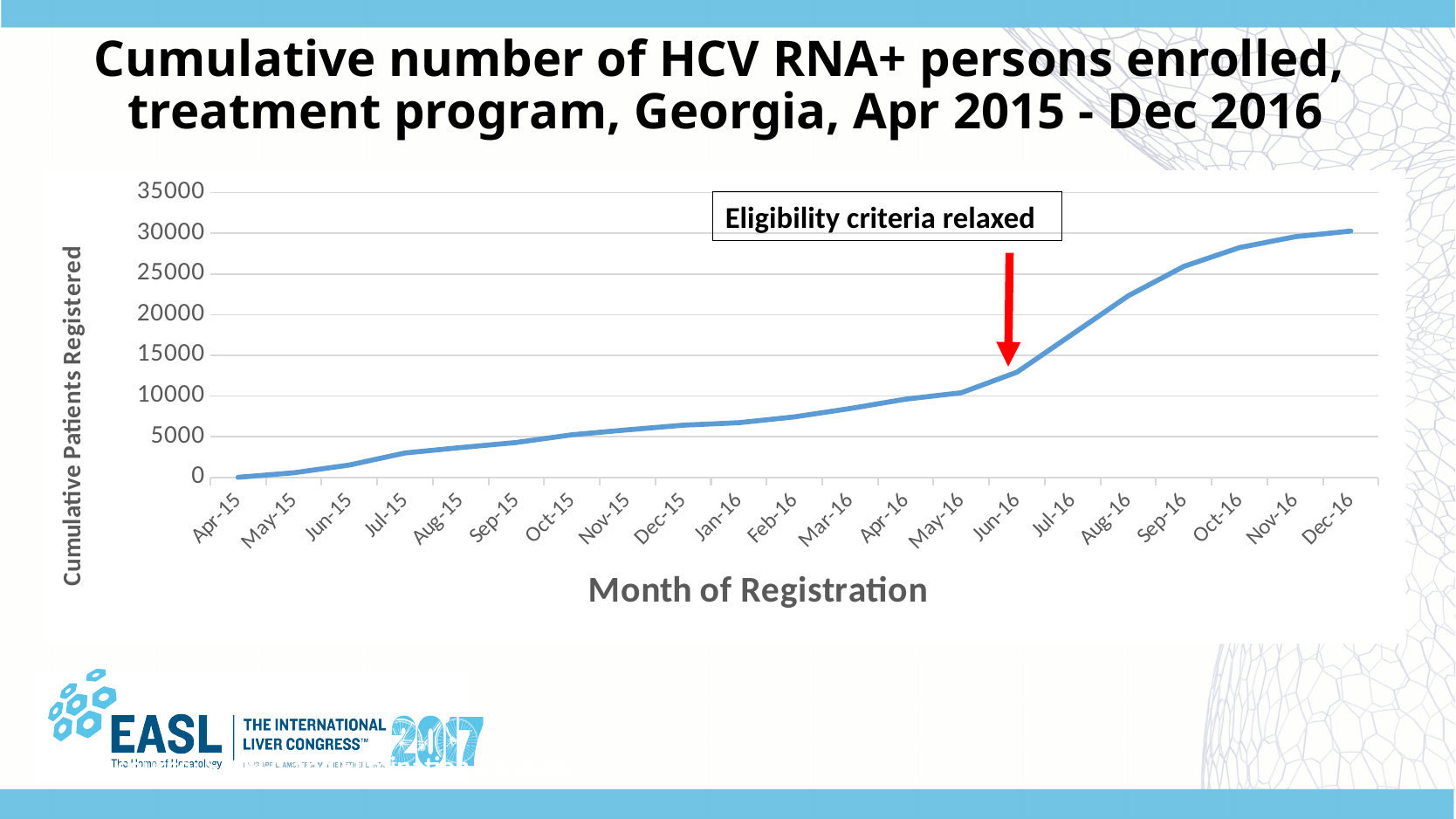
What event does the annotation with the red arrow mark on the chart? Eligibility criteria relaxed Is the value for Jul-15 greater or less than 5000? less Is the value for Dec-16 greater or less than 25000? greater Do the values rise or fall from Apr-15 to Dec-16? rise Which month has the lowest cumulative number of patients registered? Apr-15 What is the title of the x axis? Month of Registration Which month has the highest cumulative number of patients registered? Dec-16 Is the value for Jun-16 greater or less than 10000? greater What kind of chart is shown on the slide? line chart How many months are plotted along the x axis? 21